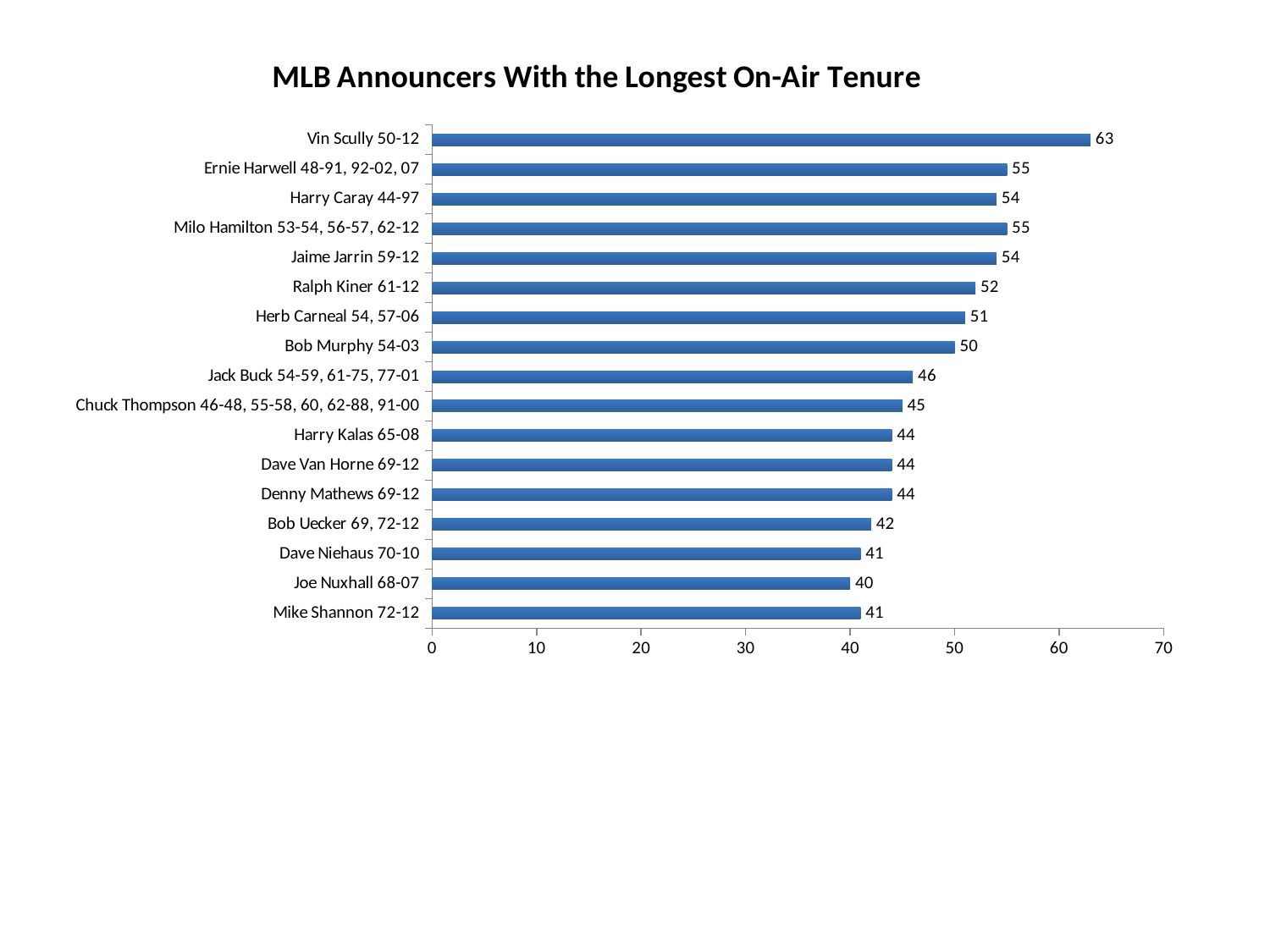
What is the title of the chart? MLB Announcers With the Longest On-Air Tenure What is the value for Joe Nuxhall 68-07? 40 Which announcer has the lowest value? Joe Nuxhall 68-07 What is the difference between the values for Vin Scully 50-12 and Ernie Harwell 48-91, 92-02, 07? 8 How many announcers are shown in the chart? 17 What kind of chart is shown on the slide? bar chart What is the value for Harry Caray 44-97? 54 What is the value for Bob Murphy 54-03? 50 Is the value for Herb Carneal 54, 57-06 greater or less than 40? greater Which is larger, the value for Ralph Kiner 61-12 or the value for Jack Buck 54-59, 61-75, 77-01? Ralph Kiner 61-12 Which announcer has the highest value? Vin Scully 50-12 What is the value for Vin Scully 50-12? 63